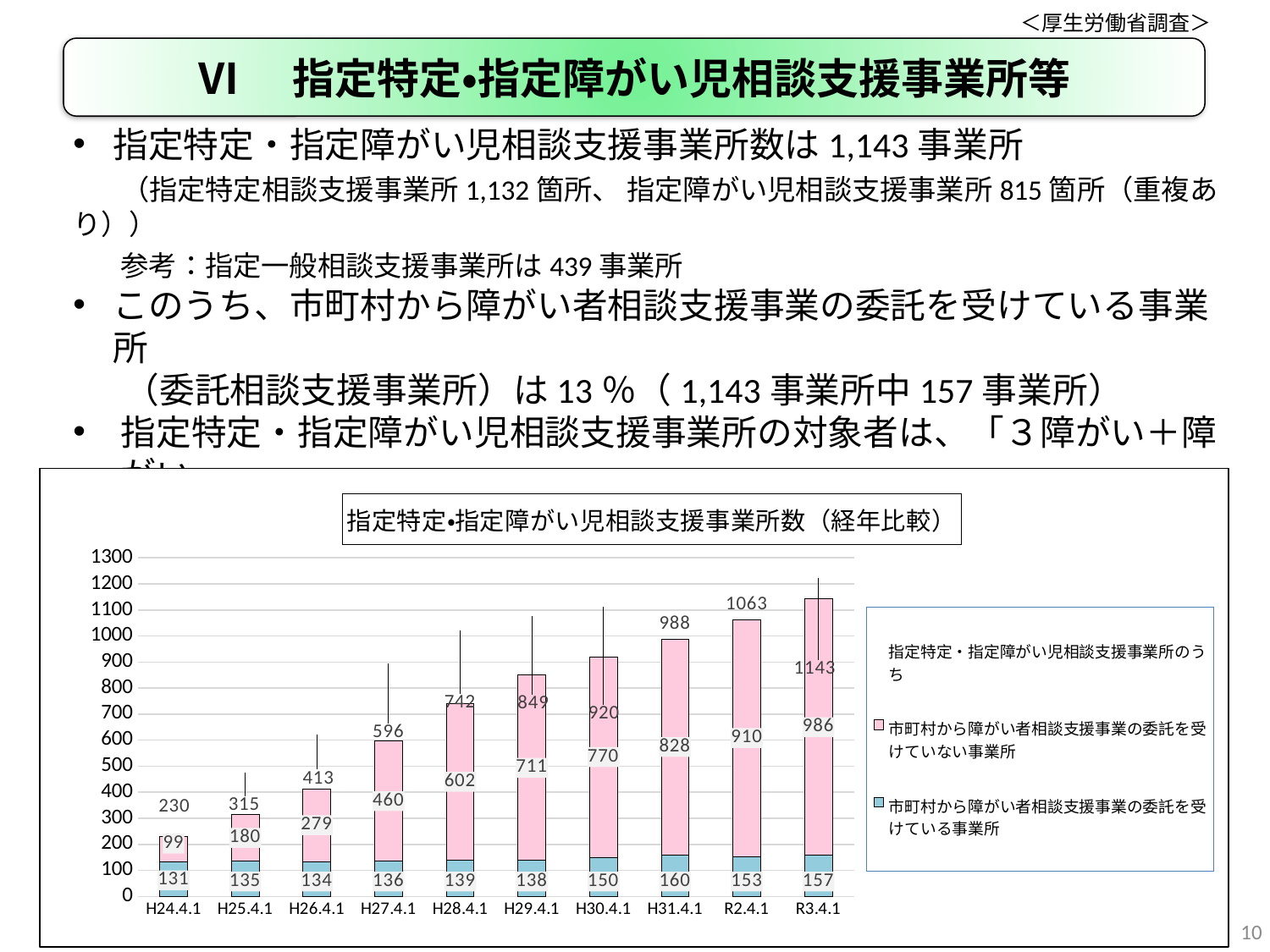
What is the difference between the values for 市町村から障がい者相談支援事業の委託を受けていない事業所 at R3.4.1 and R2.4.1? 76 Which time point has the highest value for 市町村から障がい者相談支援事業の委託を受けている事業所? H31.4.1 Which time point has the lowest value for 市町村から障がい者相談支援事業の委託を受けていない事業所? H24.4.1 What kind of chart is shown on the slide? stacked bar chart What is the value for 市町村から障がい者相談支援事業の委託を受けていない事業所 at H28.4.1? 602 Which is larger: the value for 市町村から障がい者相談支援事業の委託を受けていない事業所 at H27.4.1 or at H26.4.1? H27.4.1 How many time points (categories) are shown on the x axis of the chart? 10 Do the total bar heights rise or fall from H24.4.1 to R3.4.1? rise What is the value for 市町村から障がい者相談支援事業の委託を受けている事業所 at H31.4.1? 160 How many series does the chart's legend list? 2 What is the total of the stacked bar for R3.4.1? 1143 What is the total of the stacked bar for H24.4.1? 230